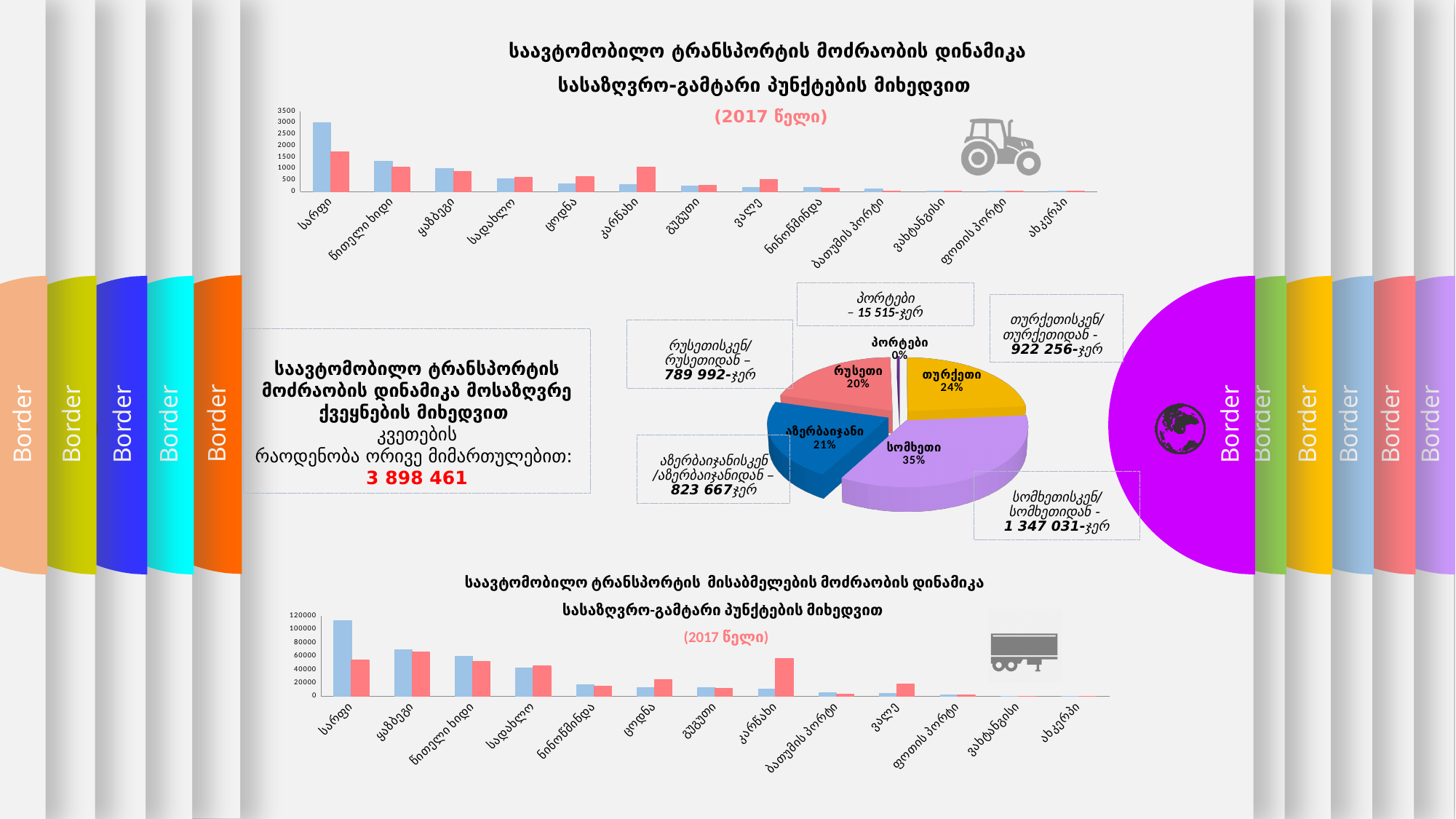
In the middle pie chart, how many slices are there? 5 How many categories are shown on the x axis of the top bar chart? 13 In the middle pie chart, what share does სომხეთი have? 35% In the middle pie chart, what share does თურქეთი have? 24% In the bottom bar chart, is the value of the blue bar for სარფი greater or less than 100000? greater What kind of chart is the top chart on the slide? bar chart In the middle pie chart, which slice is the largest? სომხეთი What kind of chart is the middle chart on the slide? pie chart In the middle pie chart, which slice is the smallest? პორტები In the middle pie chart, how many percentage points larger is სომხეთი than აზერბაიჯანი? 14 In the middle pie chart, which is larger, რუსეთი or აზერბაიჯანი? აზერბაიჯანი In the top bar chart, is the value of the blue bar for სარფი greater or less than 2500? greater